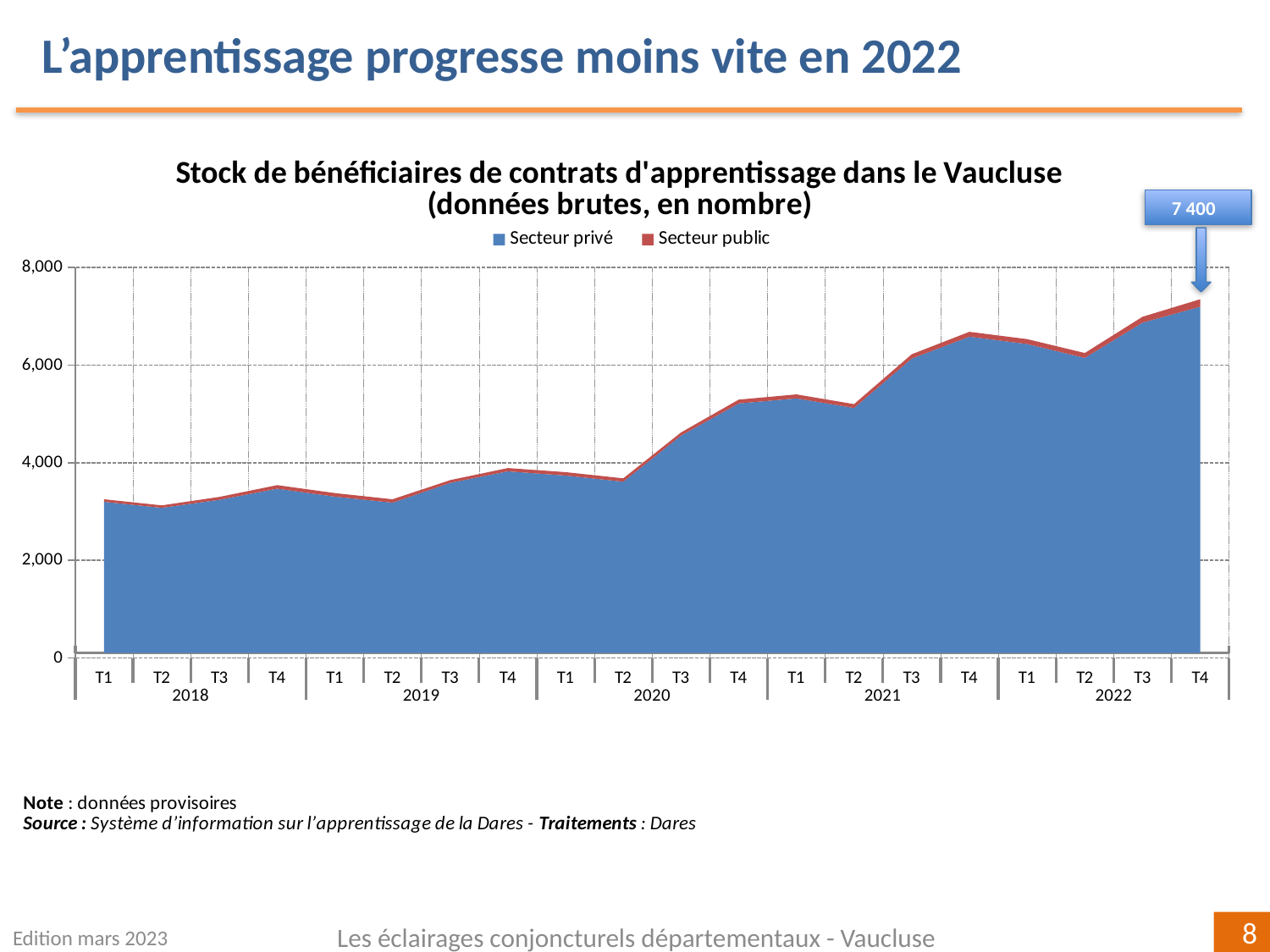
Which colour represents 'Secteur privé' in the legend? Blue Is the total value for T4 2021 greater or less than 6,000? greater How many series does the legend list? 2 How many quarterly data points are plotted along the x axis? 20 What kind of chart is shown on the slide? Stacked area chart Which is larger, the total for T4 2021 or the total for T2 2022? T4 2021 Which quarter has the highest total stock of apprenticeship beneficiaries? T4 2022 Is the total value for T1 2021 greater or less than 6,000? less What total value is called out for T4 2022? 7 400 Is the total value for T4 2020 greater or less than 4,000? greater Overall, do the values rise or fall from 2018 to 2022? rise